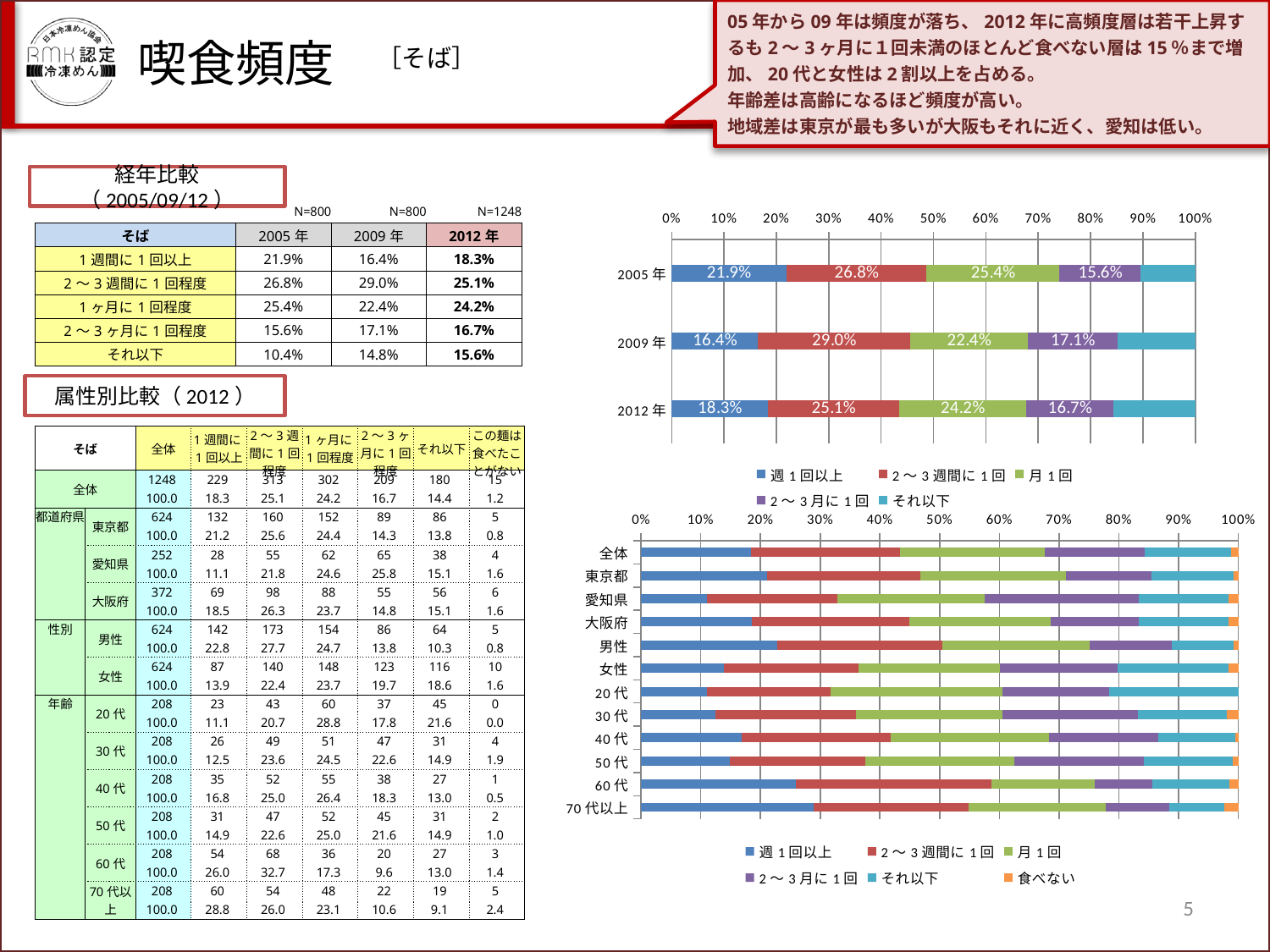
In the top-right chart, which year has the larger value for 2～3週間に1回, 2009年 or 2012年? 2009年 In the top-right chart, which year has the lowest value for 2～3月に1回? 2005年 How many series does the legend of the top-right chart list? 5 What kind of chart is the bottom-right chart? Stacked bar chart How many series does the legend of the bottom-right chart list? 6 In the top-right chart, what is the value for 2～3週間に1回 in 2009年? 29.0% How many years are plotted in the top-right chart? 3 In the top-right chart, what is the value for 月1回 in 2012年? 24.2% In the top-right chart, what is the difference between the 週1回以上 values for 2005年 and 2012年? 3.6 percentage points In the top-right chart, what is the value for 週1回以上 in 2005年? 21.9% In the top-right chart, which year has the highest value for 週1回以上? 2005年 In the bottom-right chart, is the value for 週1回以上 for 20代 greater or less than 20%? less